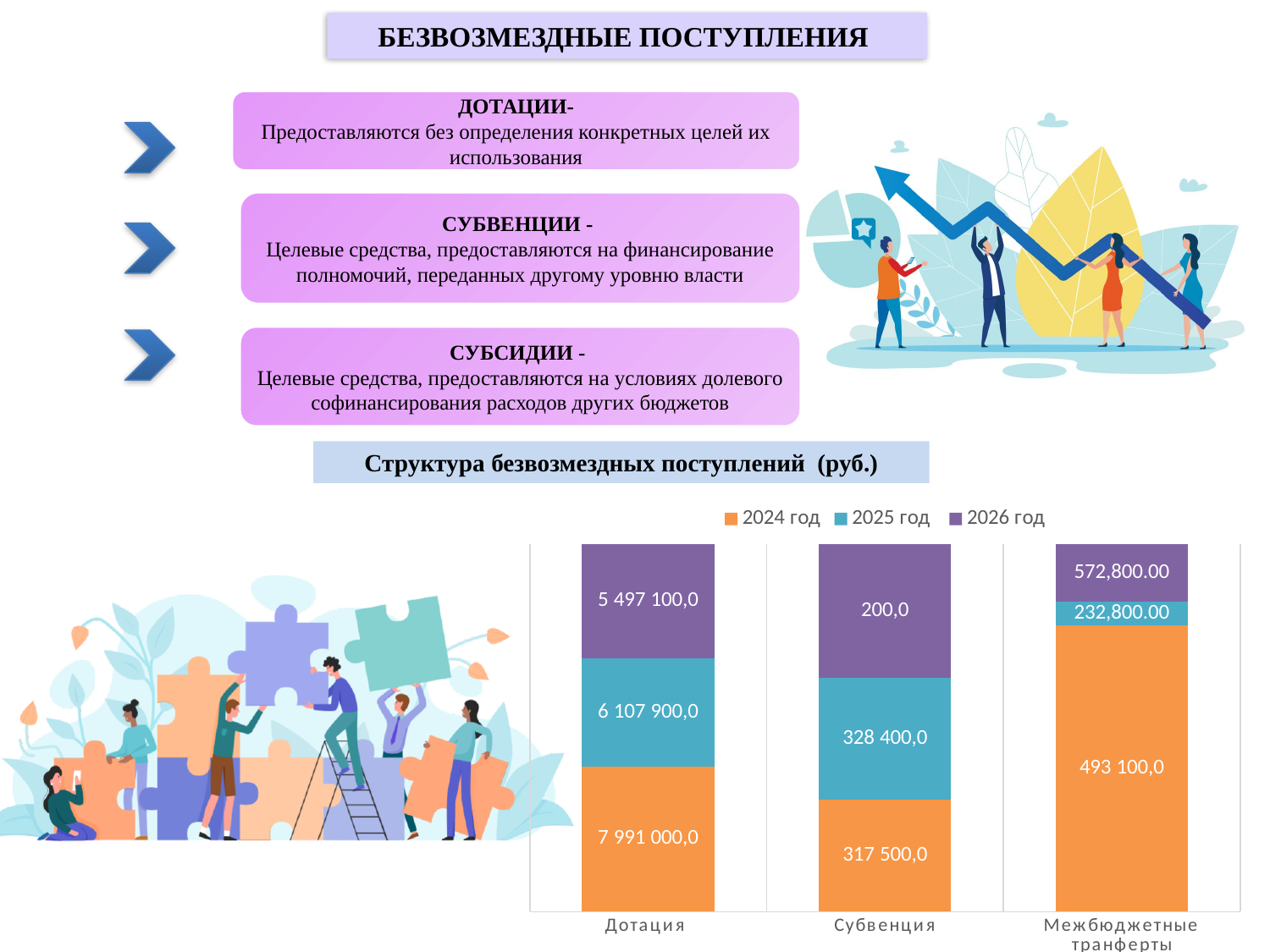
What is the value for Межбюджетные транферты in 2026 год? 572,800.00 Which colour represents the series 2026 год in the chart? purple What type of chart is shown under the title 'Структура безвозмездных поступлений (руб.)'? stacked bar chart Which is larger for Межбюджетные транферты: the value for 2024 год or the value for 2025 год? 2024 год What is the value for Субвенция in 2025 год? 328 400,0 How many series does the legend of the chart list? 3 How many categories are shown on the x axis of the chart? 3 What is the value for Дотация in 2024 год? 7 991 000,0 Which year has the highest value for Дотация? 2024 год Which year has the lowest value for Субвенция? 2026 год What is the value for Субвенция in 2026 год? 200,0 What is the difference between the Дотация values for 2024 год and 2025 год? 1 883 100,0